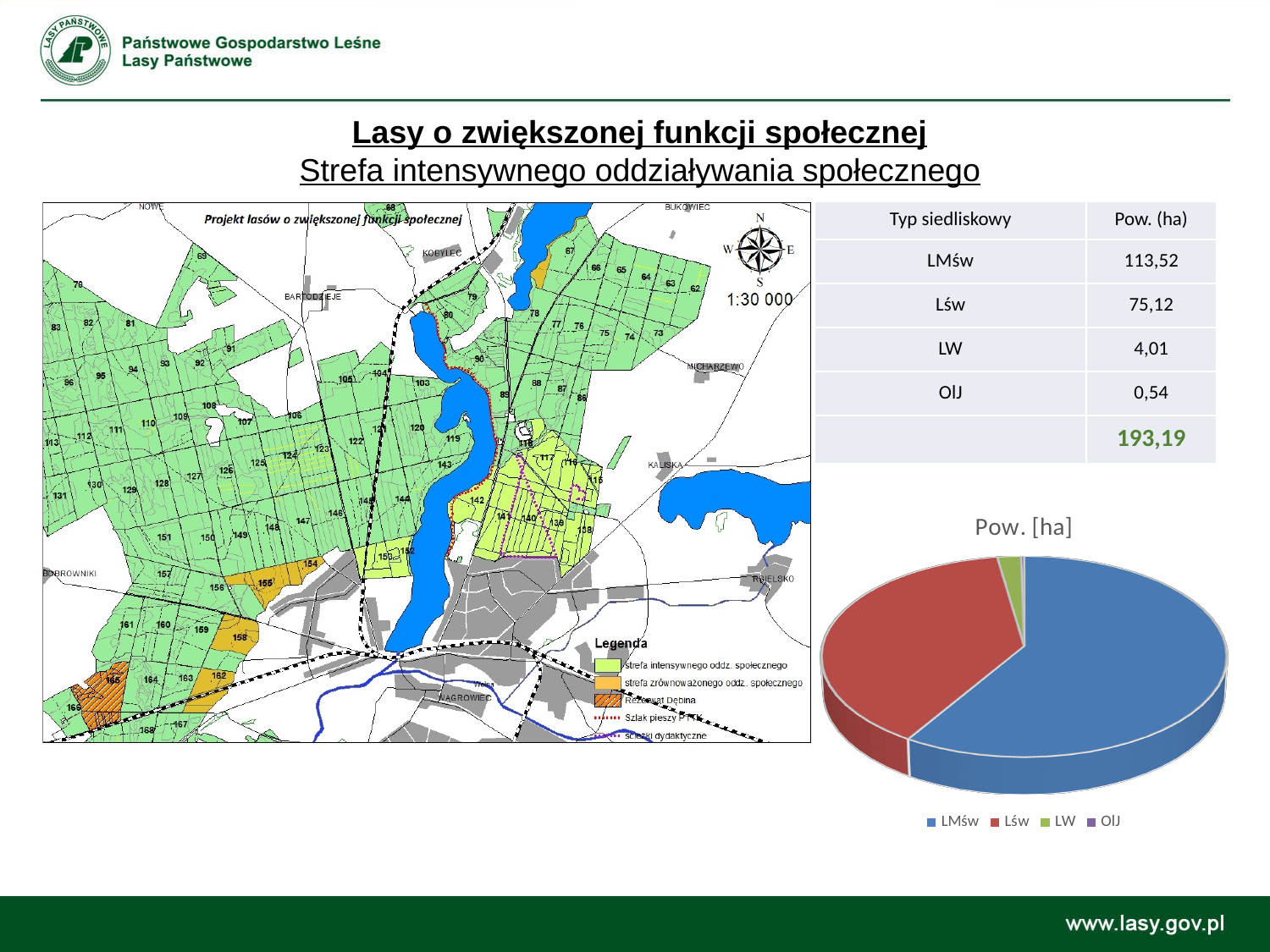
What kind of chart is shown on the right side of the slide under the table? pie chart What colour is the LMśw slice in the pie chart? blue How many categories does the legend of the pie chart list? 4 What is the total area (Pow. ha) shown in the table for all habitat types? 193,19 What is the difference in area (ha) between LMśw and Lśw according to the table? 38,40 What is the title of the pie chart? Pow. [ha] Which slice is larger in the pie chart, Lśw or LW? Lśw According to the table, what is the area (Pow. ha) for LMśw? 113,52 Which category has the smallest slice in the pie chart? OlJ According to the table, what is the area (Pow. ha) for Lśw? 75,12 According to the table, what is the area (Pow. ha) for OlJ? 0,54 Which category has the largest slice in the pie chart? LMśw